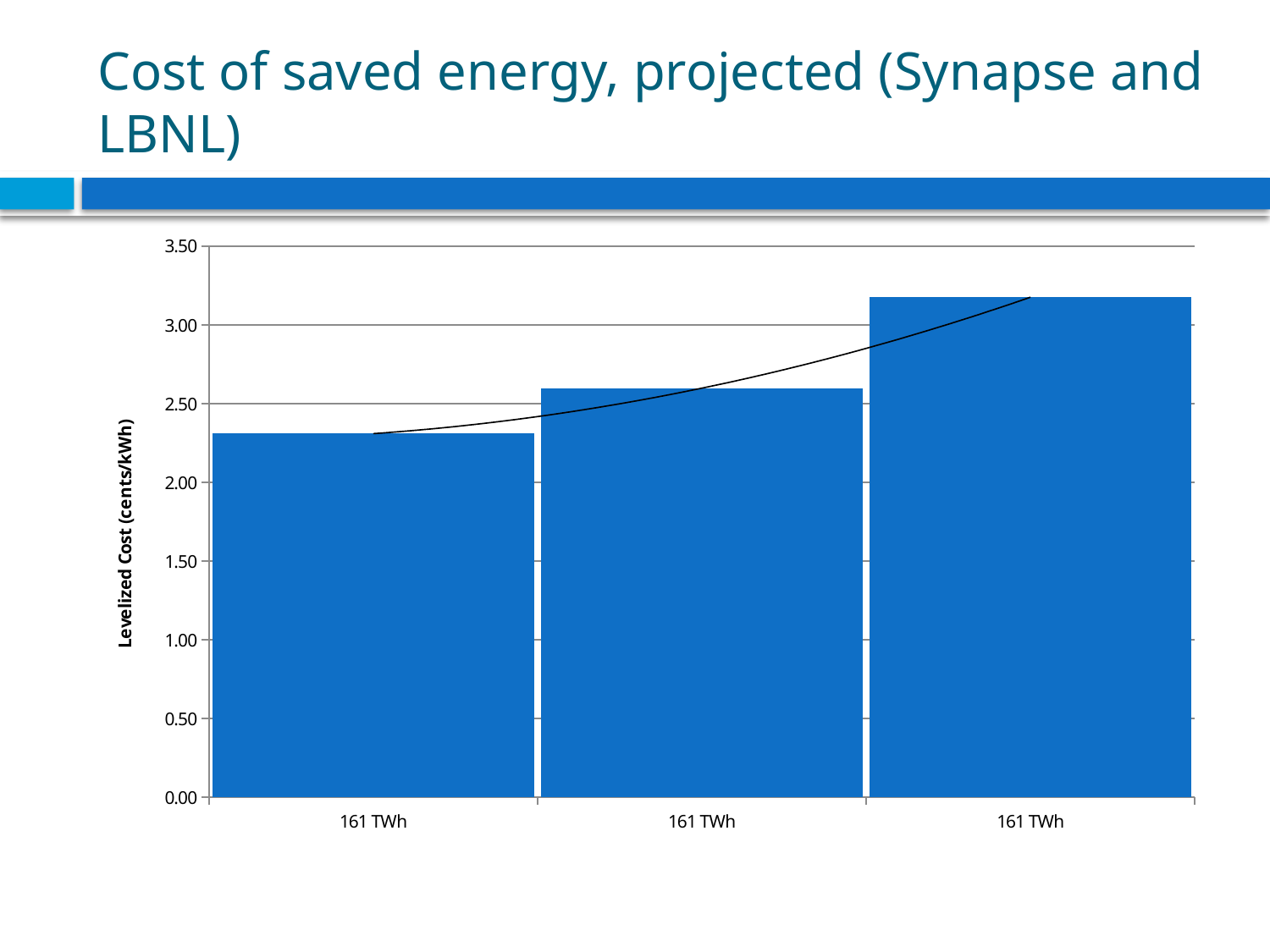
Is the value for the leftmost bar greater or less than 2.50? less What is the title of the vertical axis? Levelized Cost (cents/kWh) How many bars are plotted in the chart? 3 Which is larger, the value of the leftmost bar or the value of the rightmost bar? the rightmost bar Is the value for the middle bar greater or less than 2.50? greater Is the value for the rightmost bar greater or less than 3.00? greater What kind of chart is shown on the slide? bar chart Do the bar values rise or fall from left to right along the x axis? rise Which bar has the lowest levelized cost? the leftmost (first) bar What label appears under each bar on the x axis? 161 TWh Which bar has the highest levelized cost? the rightmost (third) bar